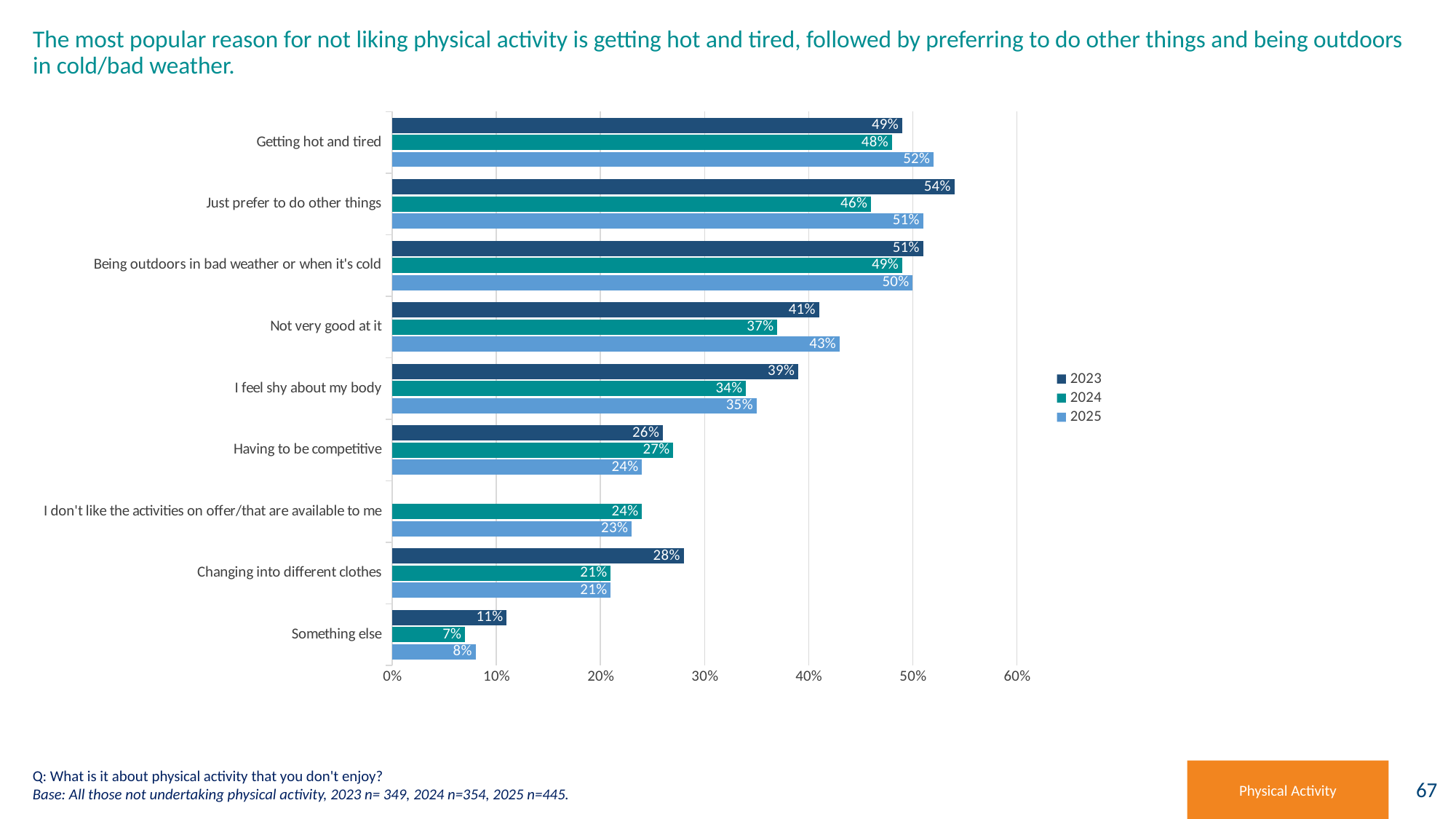
How many series does the legend list? 3 What is the 2023 value for 'Just prefer to do other things'? 54% Is the 2025 value for 'I feel shy about my body' greater or less than 40%? less What is the difference between the 2023 and 2024 values for 'Just prefer to do other things'? 8 percentage points What is the 2024 value for 'Not very good at it'? 37% Which series is missing a bar for 'I don't like the activities on offer/that are available to me'? 2023 Which is larger for 'Having to be competitive': the 2024 value or the 2025 value? 2024 How many categories are shown on the y axis? 9 Which category has the highest 2023 value? Just prefer to do other things What is the 2025 value for 'Getting hot and tired'? 52% Which category has the lowest 2024 value? Something else What kind of chart is shown on the slide? Bar chart